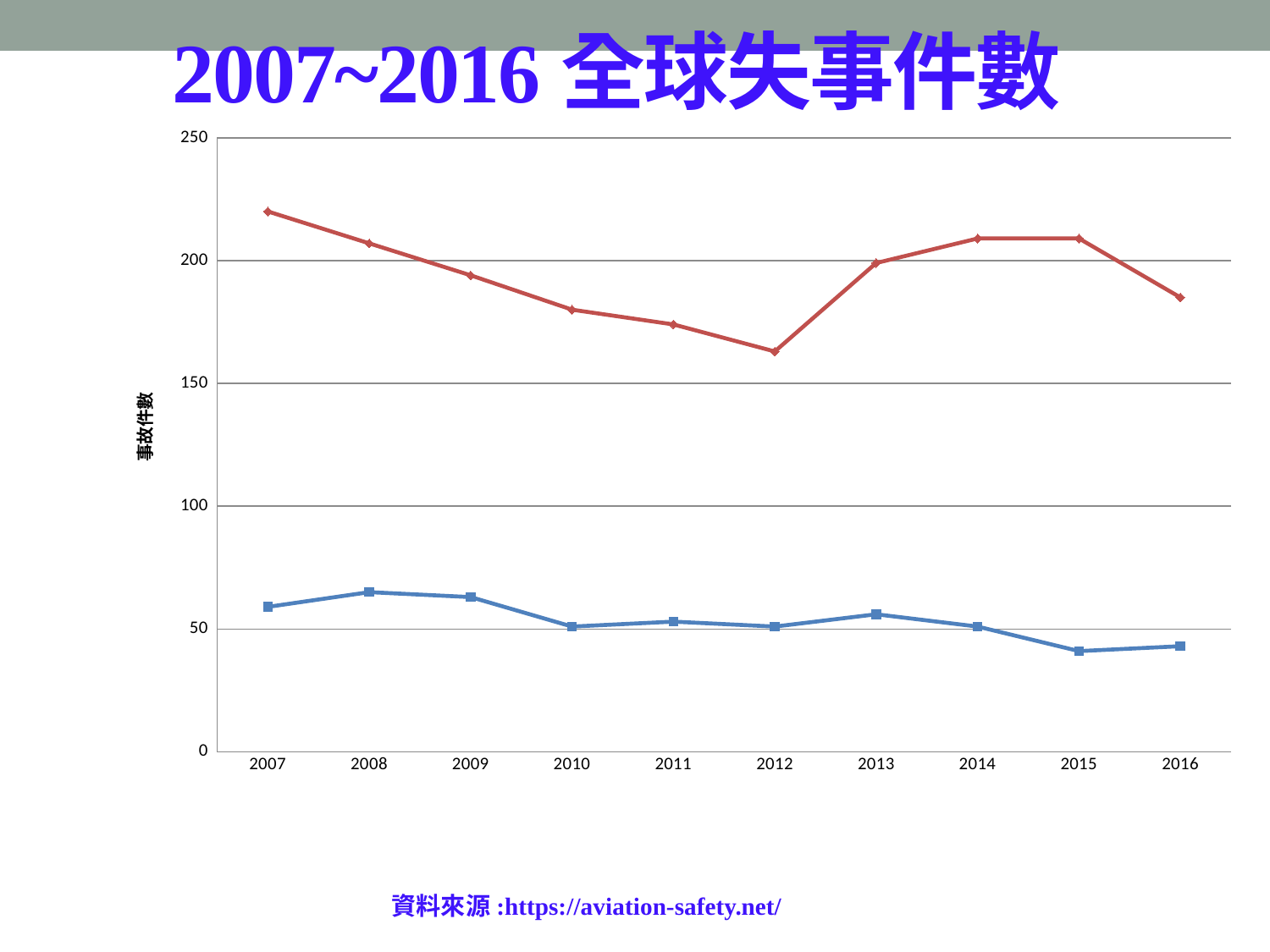
Is the value of the blue line in 2015 greater or less than 50? less Which is larger for the red line: the value in 2013 or the value in 2016? 2013 How many years are plotted along the x axis? 10 Is the value of the red line in 2012 greater or less than 150? greater Is the value of the red line in 2007 greater or less than 200? greater What is the title of the chart? 2007~2016 全球失事件數 What kind of chart is shown on the slide? line chart Does the red line rise or fall from 2007 to 2012? fall What is the label on the vertical axis? 事故件數 In which year does the red line reach its lowest value? 2012 In which year does the red line reach its highest value? 2007